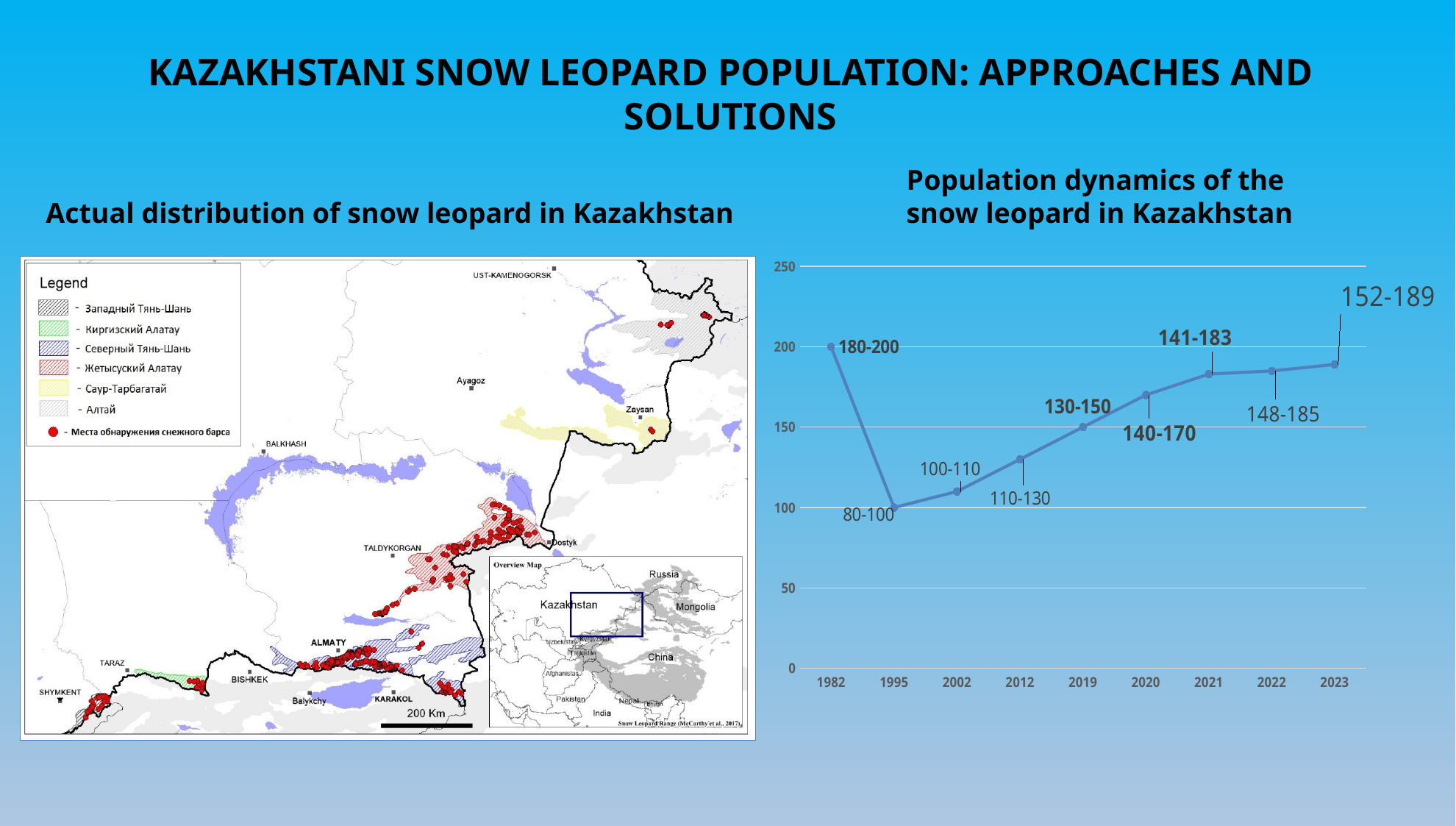
In the 'Population dynamics of the snow leopard in Kazakhstan' chart, how many years are plotted on the x axis? 9 In the 'Population dynamics of the snow leopard in Kazakhstan' chart, which year has the lowest plotted value? 1995 In the 'Population dynamics of the snow leopard in Kazakhstan' chart, what is the data label for 2023? 152-189 In the 'Population dynamics of the snow leopard in Kazakhstan' chart, what is the data label for 1995? 80-100 In the 'Population dynamics of the snow leopard in Kazakhstan' chart, what is the data label for 2021? 141-183 In the 'Population dynamics of the snow leopard in Kazakhstan' chart, which year has the larger plotted value, 2012 or 2022? 2022 In the 'Population dynamics of the snow leopard in Kazakhstan' chart, do the values rise or fall from 1995 to 2023? Rise In the 'Population dynamics of the snow leopard in Kazakhstan' chart, is the plotted value for 2002 greater or less than 150? less In the 'Population dynamics of the snow leopard in Kazakhstan' chart, which year has the highest plotted value? 1982 In the 'Population dynamics of the snow leopard in Kazakhstan' chart, what is the data label for 1982? 180-200 In the 'Population dynamics of the snow leopard in Kazakhstan' chart, what is the data label for 2012? 110-130 What kind of chart is 'Population dynamics of the snow leopard in Kazakhstan'? Line chart